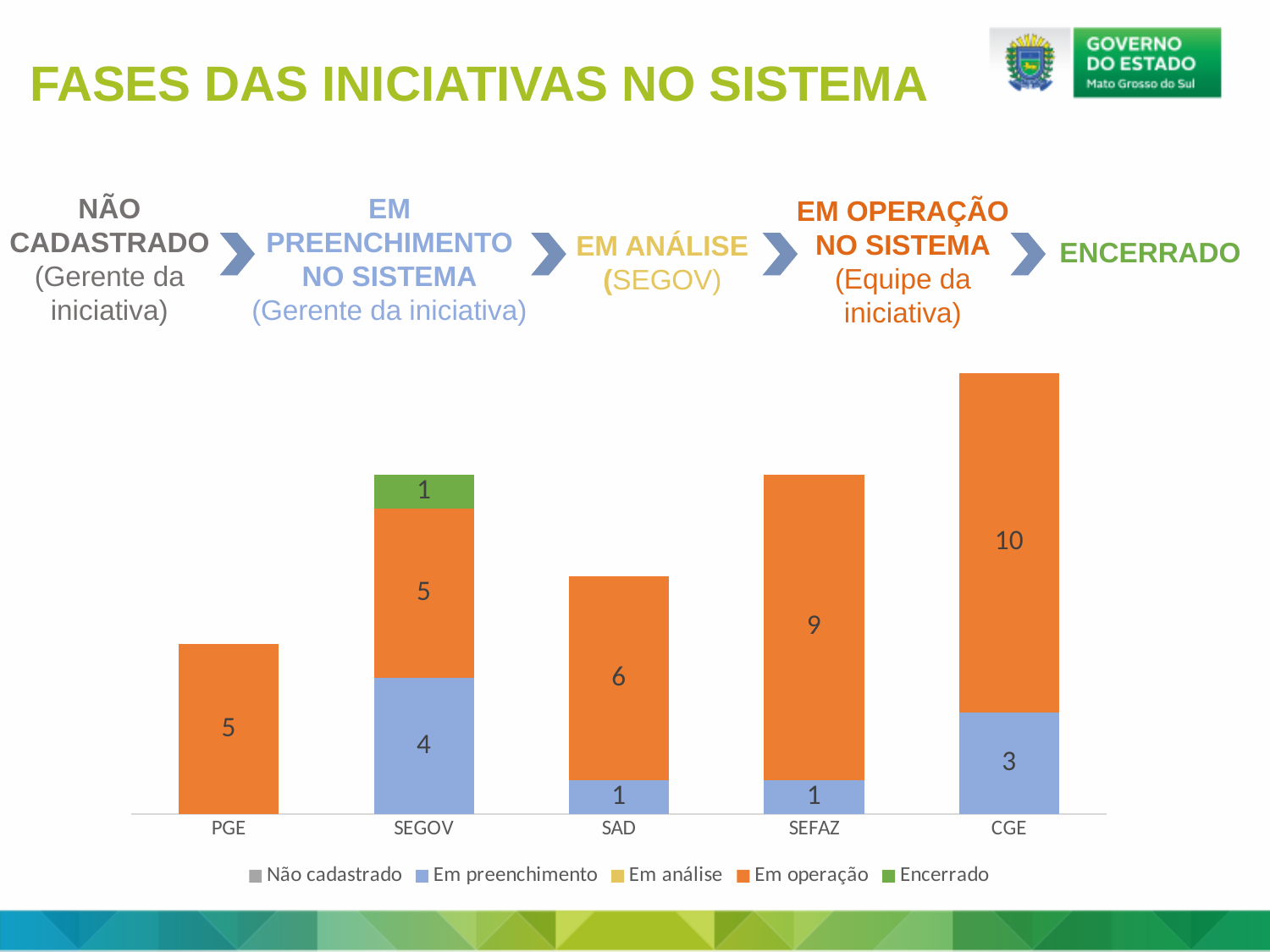
What is the value of Em operação for CGE? 10 Which category has the highest total stacked bar? CGE Which category has the lowest total stacked bar? PGE How many series does the chart legend list? 5 What is the value of Em operação for SAD? 6 What is the value of Encerrado for SEGOV? 1 What is the value of Em preenchimento for SEGOV? 4 What type of chart is shown on the slide? Stacked bar chart What is the total of the stacked bar for SEFAZ? 10 What is the difference between the Em operação values for CGE and PGE? 5 How many categories are shown on the x axis of the chart? 5 Which is larger, the Em operação value for SEFAZ or for SAD? SEFAZ